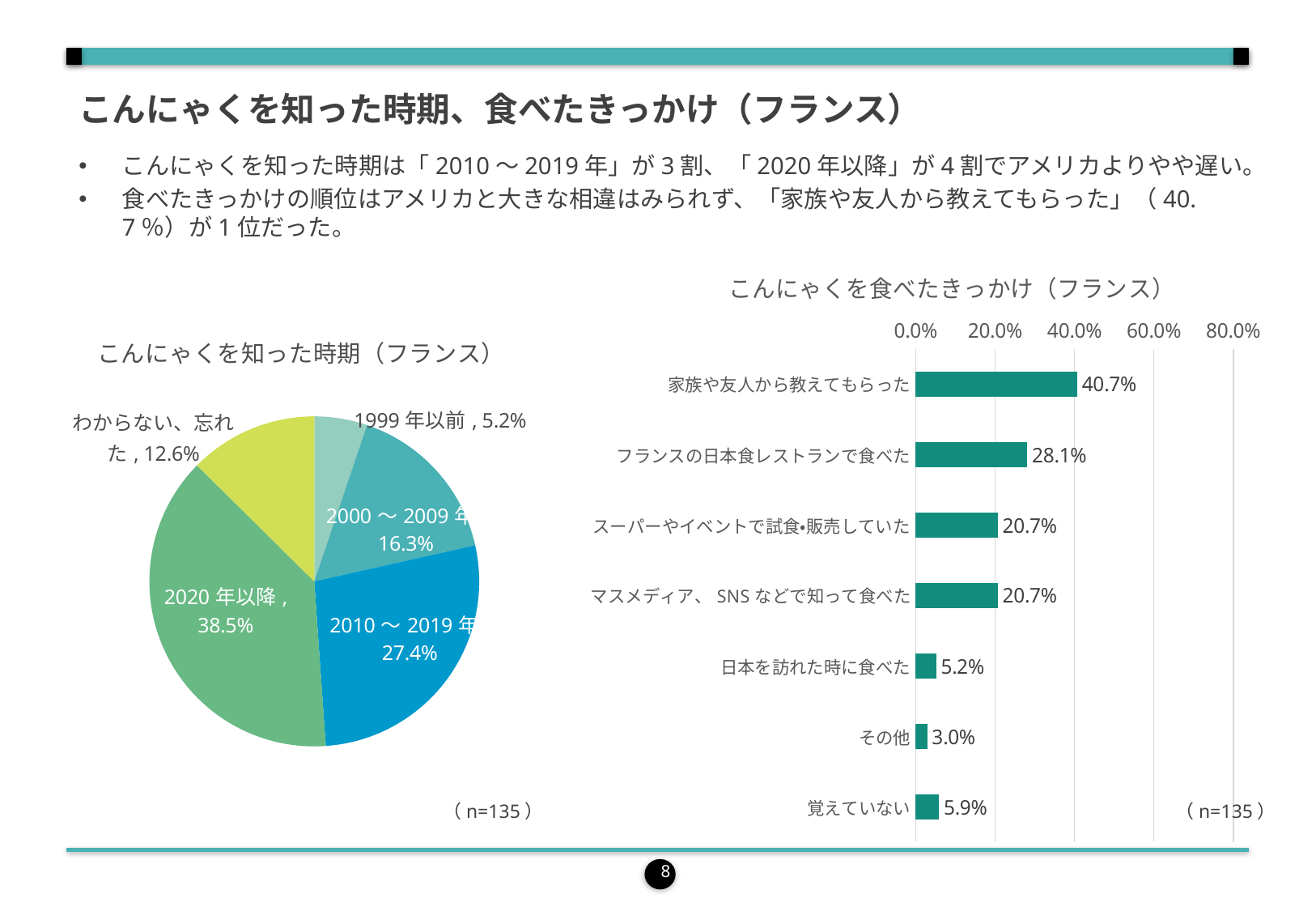
In the pie chart こんにゃくを知った時期（フランス）, what is the share for 1999年以前? 5.2% In the bar chart こんにゃくを食べたきっかけ（フランス）, which category has the lowest value? その他 In the pie chart こんにゃくを知った時期（フランス）, how many slices are there? 5 What type of chart is こんにゃくを食べたきっかけ（フランス）? bar chart In the bar chart こんにゃくを食べたきっかけ（フランス）, what is the value for 家族や友人から教えてもらった? 40.7% In the pie chart こんにゃくを知った時期（フランス）, which category has the largest share? 2020年以降 In the bar chart こんにゃくを食べたきっかけ（フランス）, what is the value for フランスの日本食レストランで食べた? 28.1% In the pie chart こんにゃくを知った時期（フランス）, which category has the smallest share? 1999年以前 In the pie chart こんにゃくを知った時期（フランス）, what is the share for 2020年以降? 38.5% In the bar chart こんにゃくを食べたきっかけ（フランス）, which is larger: 日本を訪れた時に食べた or 覚えていない? 覚えていない In the bar chart こんにゃくを食べたきっかけ（フランス）, how many categories are shown? 7 In the pie chart こんにゃくを知った時期（フランス）, what is the difference between 2010～2019年 and 2000～2009年? 11.1%